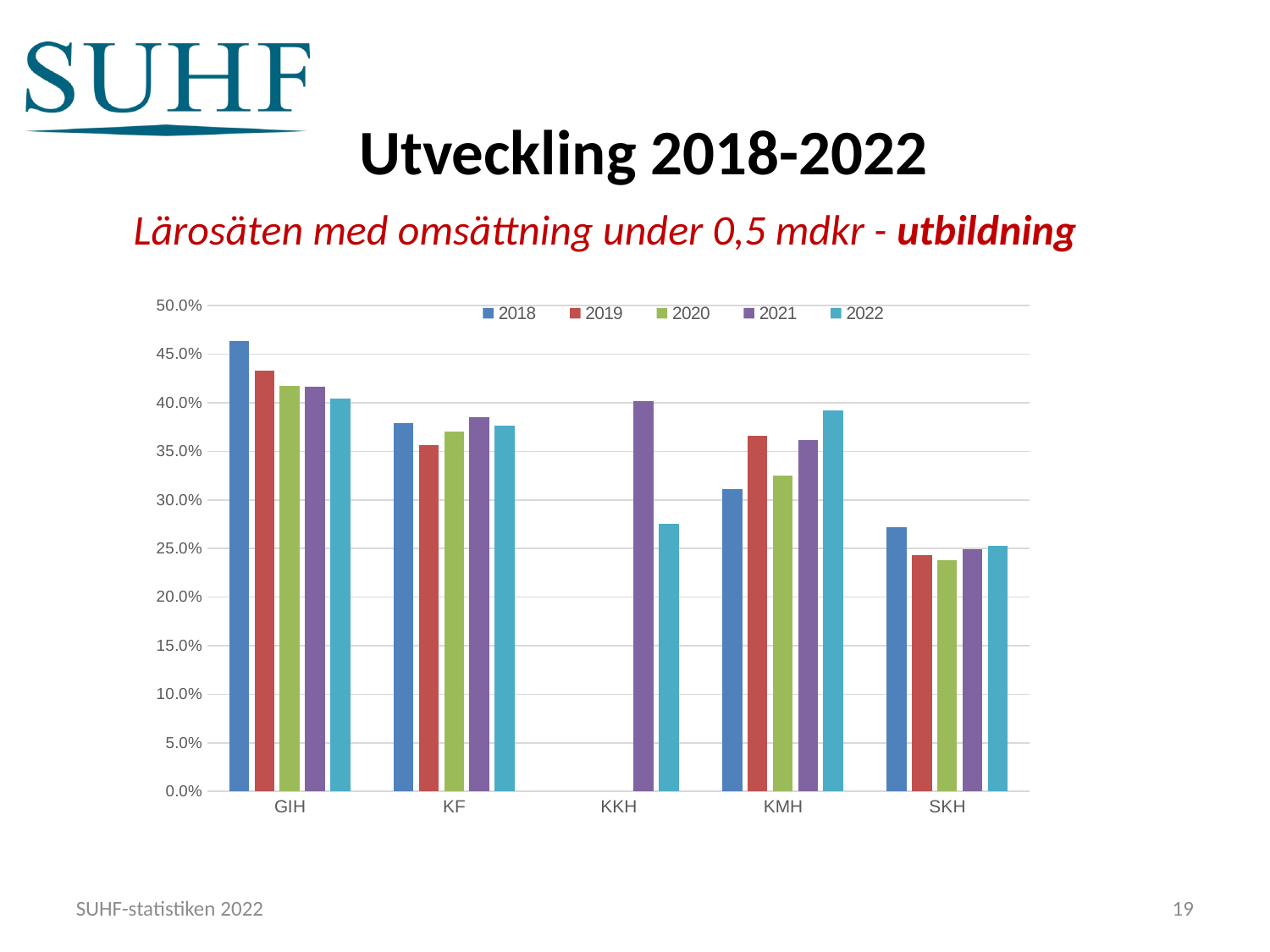
Which category has the lowest value for 2022? SKH Which category has bars only for 2021 and 2022? KKH Is the value for GIH in 2018 greater or less than 45.0%? greater What kind of chart is shown on the slide? bar chart Is the value for KKH in 2022 greater or less than 30.0%? less Do the values for GIH rise or fall from 2018 to 2022? fall For SKH, which is larger: the value for 2018 or the value for 2019? 2018 How many series does the legend list? 5 Is the value for KF in 2019 greater or less than 40.0%? less For KMH, which is larger: the value for 2018 or the value for 2022? 2022 How many categories are shown on the x axis? 5 Which category has the highest value for 2018? GIH